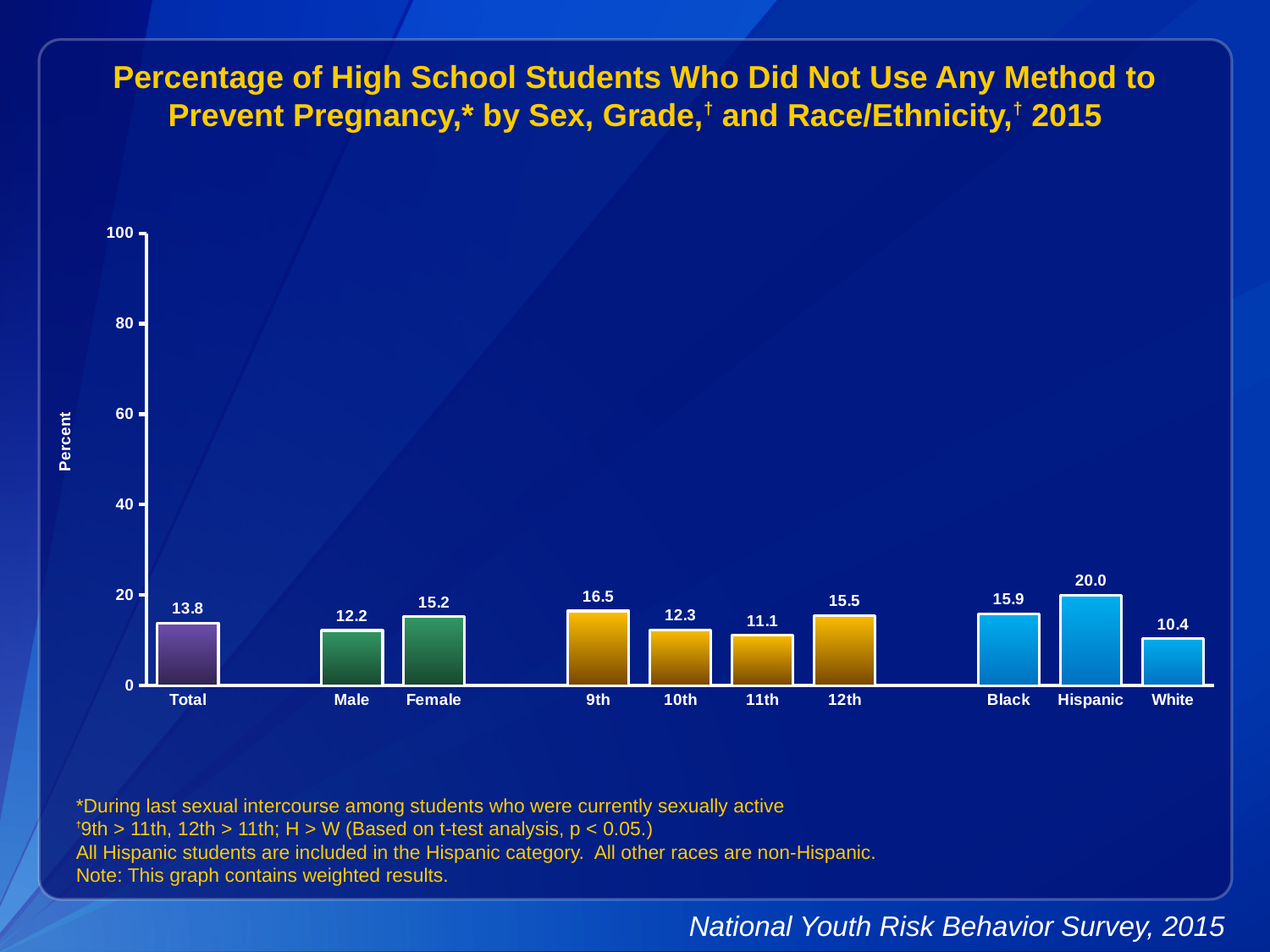
What is the value for 11th grade? 11.1 What is the value for Total? 13.8 How many categories are shown on the x axis? 10 Which is larger, the value for 9th grade or 12th grade? 9th What is the difference between the Female and Male values? 3.0 Which category has the lowest value? White What is the value for Hispanic students? 20.0 Which category has the highest value? Hispanic What is the difference between the Hispanic and White values? 9.6 What is the label on the y axis? Percent What kind of chart is this? bar chart Is the value for Black students greater or less than 20? less